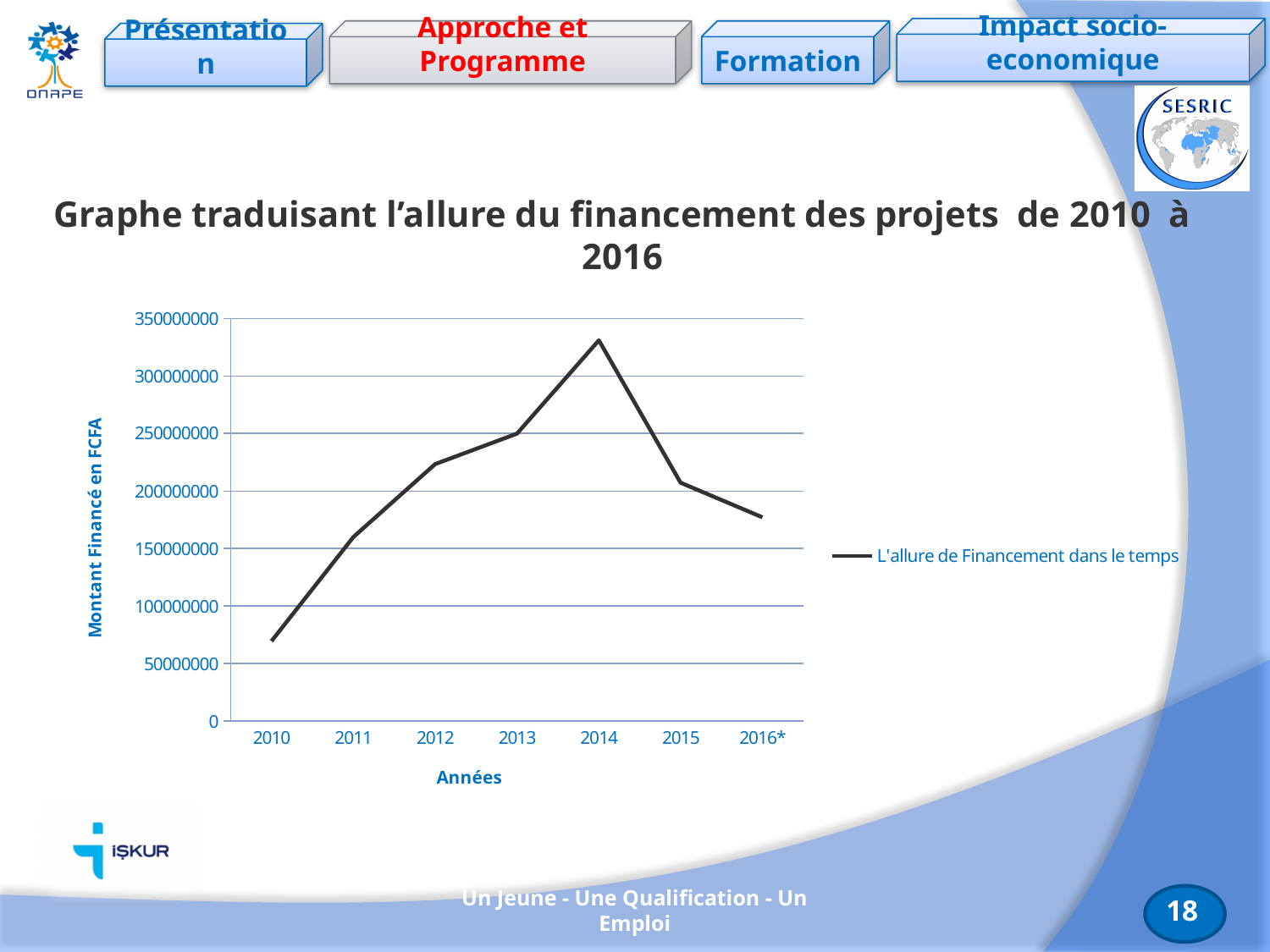
Is the value for 2014 greater or less than 300000000? greater Which year has a larger financed amount, 2013 or 2015? 2013 What kind of chart is shown on the slide? line chart Is the value for 2010 greater or less than 100000000? less In which year is the financed amount highest? 2014 What is the title of the vertical axis of the chart? Montant Financé en FCFA In which year is the financed amount lowest? 2010 Do the values rise or fall from 2010 to 2014? rise Is the value for 2012 greater or less than 200000000? greater How many years are plotted on the x axis of the chart? 7 How many series does the chart legend list? 1